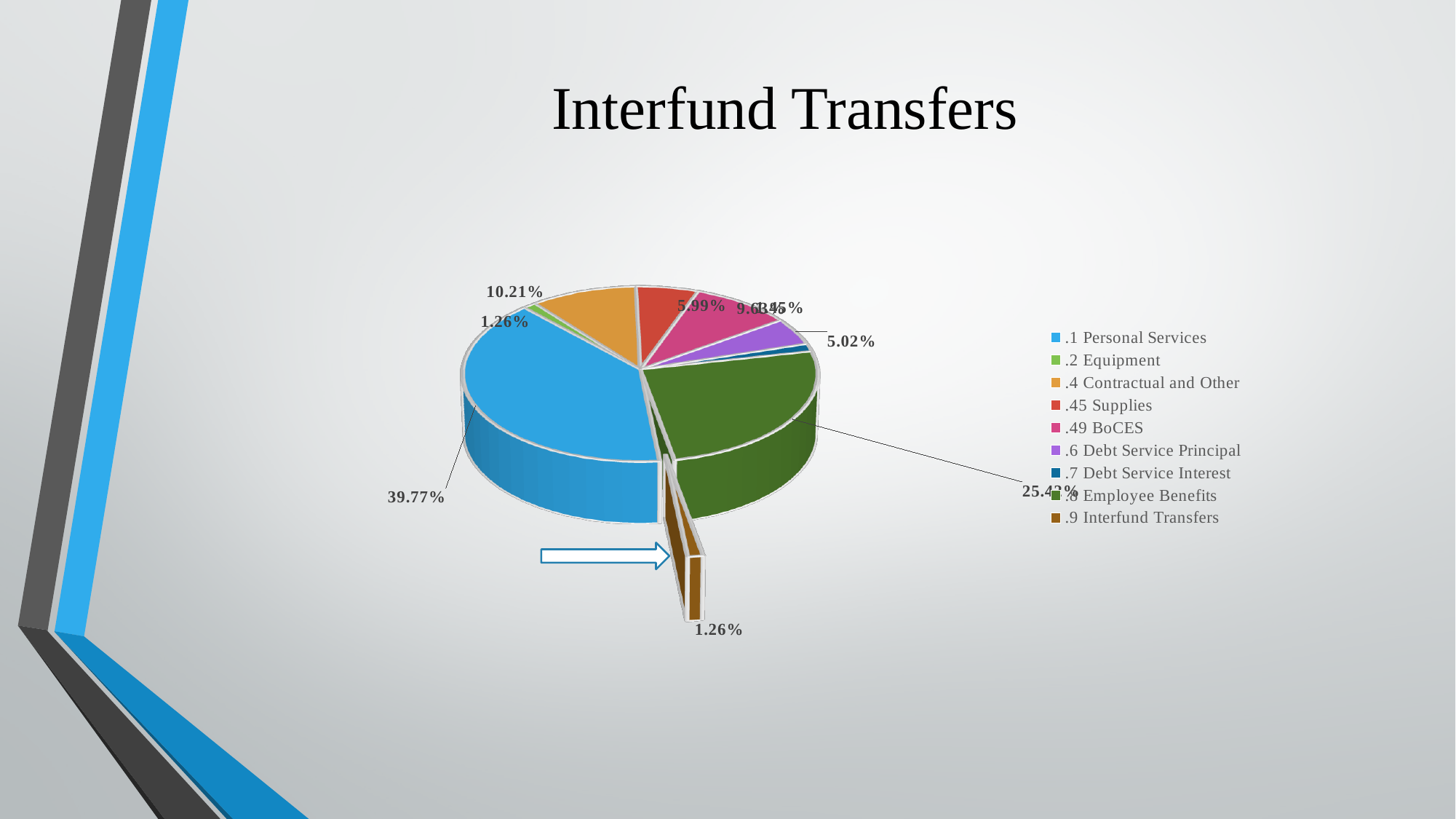
What share of the pie does .1 Personal Services have? 39.77% What is the difference in percentage points between .1 Personal Services and .4 Contractual and Other? 29.56 What percentage is shown for .45 Supplies? 5.99% How many categories does the legend list? 9 What kind of chart is shown on the slide? pie chart What percentage is shown for .6 Debt Service Principal? 5.02% What percentage is shown for the .9 Interfund Transfers slice? 1.26% What percentage is shown for .4 Contractual and Other? 10.21% What is the title of the chart? Interfund Transfers Which category has the largest slice of the pie? .1 Personal Services What percentage is shown for .2 Equipment? 1.26% Which is larger, the slice for .45 Supplies or the slice for .6 Debt Service Principal? .45 Supplies